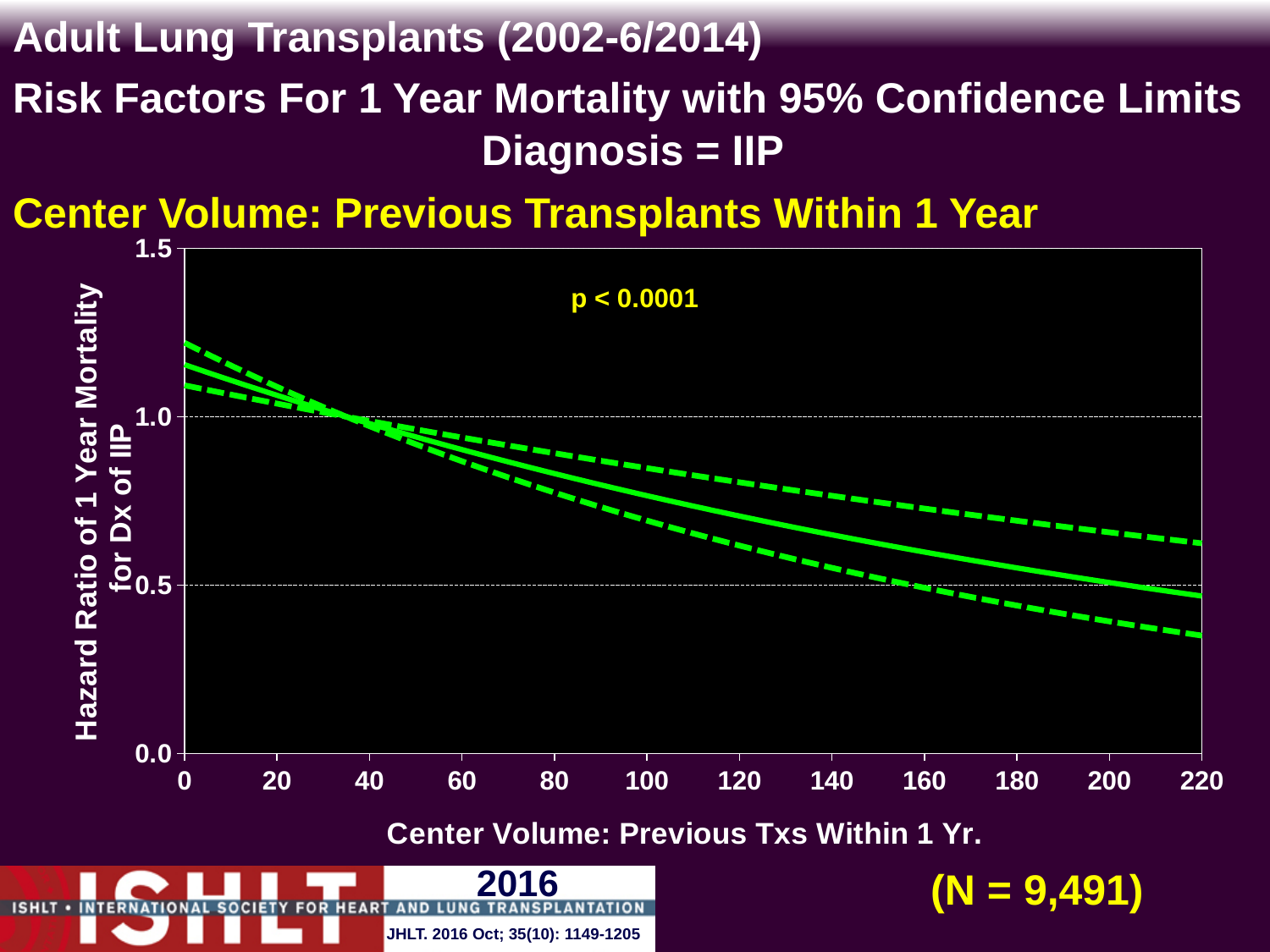
Is the hazard ratio (solid line) at a center volume of 60 greater or less than 0.5? greater What is the maximum value shown on the y axis? 1.5 Is the hazard ratio (solid line) at a center volume of 100 greater or less than 1.0? less How many tick labels are shown on the x axis? 12 What kind of chart is shown on the slide? line chart Is the lower dashed confidence limit at a center volume of 220 greater or less than 0.5? less What p-value is printed on the chart? p < 0.0001 Does the solid hazard ratio line rise or fall as center volume increases along the x axis? fall